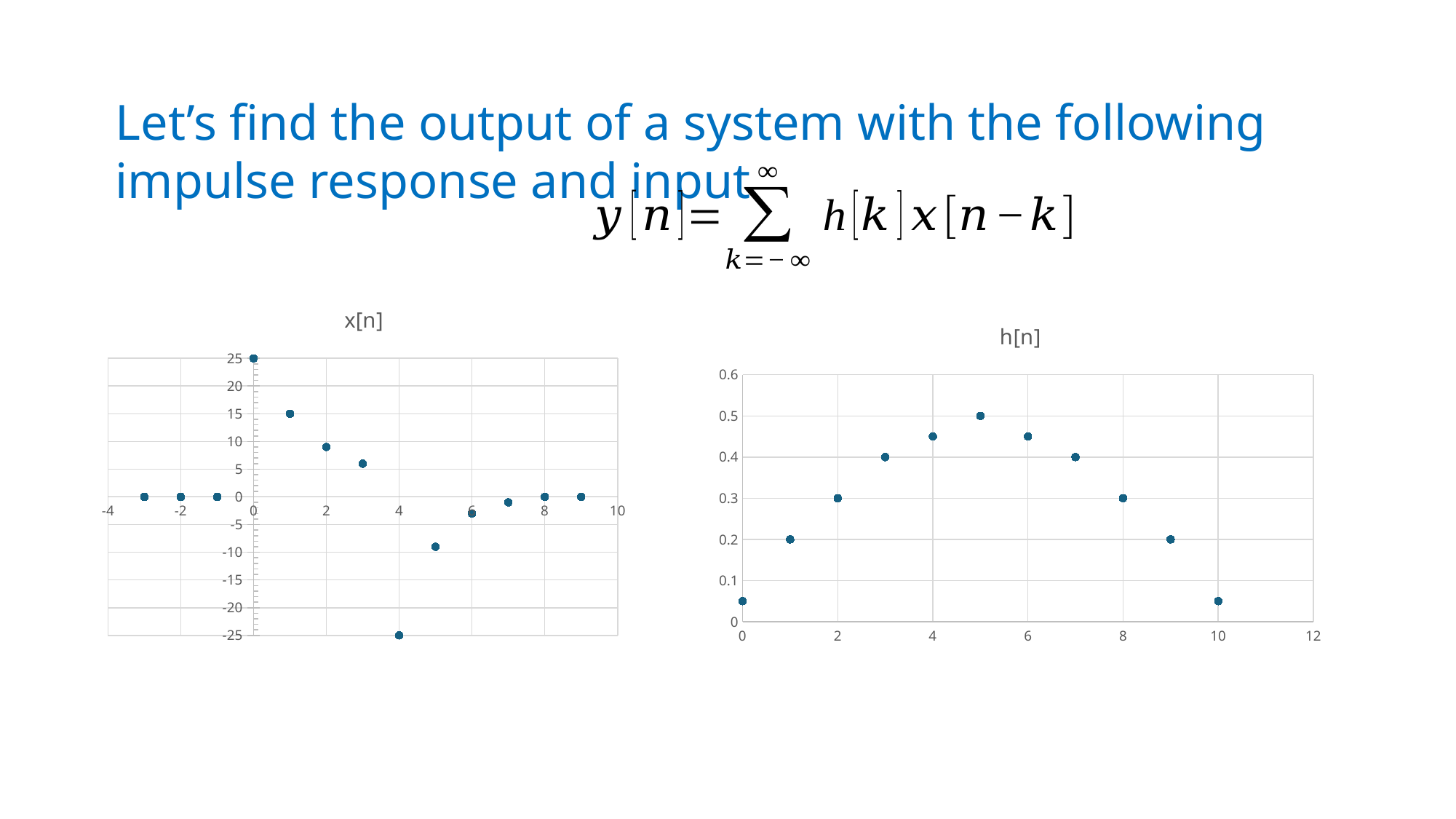
In the h[n] chart, at which value of n is the plotted value highest? 5 In the h[n] chart, what is the value at n = 2? 0.3 In the x[n] chart, what is the difference between the values at n = 0 and n = 1? 10 In the h[n] chart, which is larger: the value at n = 3 or the value at n = 8? n = 3 How many data points are plotted in the h[n] chart? 11 In the x[n] chart, what is the value at n = 1? 15 In the x[n] chart, at which value of n is the plotted value highest? 0 In the h[n] chart, is the value at n = 4 greater or less than 0.4? greater In the x[n] chart, at which value of n is the plotted value lowest? 4 What are the titles of the two charts on the slide? x[n] and h[n] What kind of chart is the x[n] chart? scatter chart